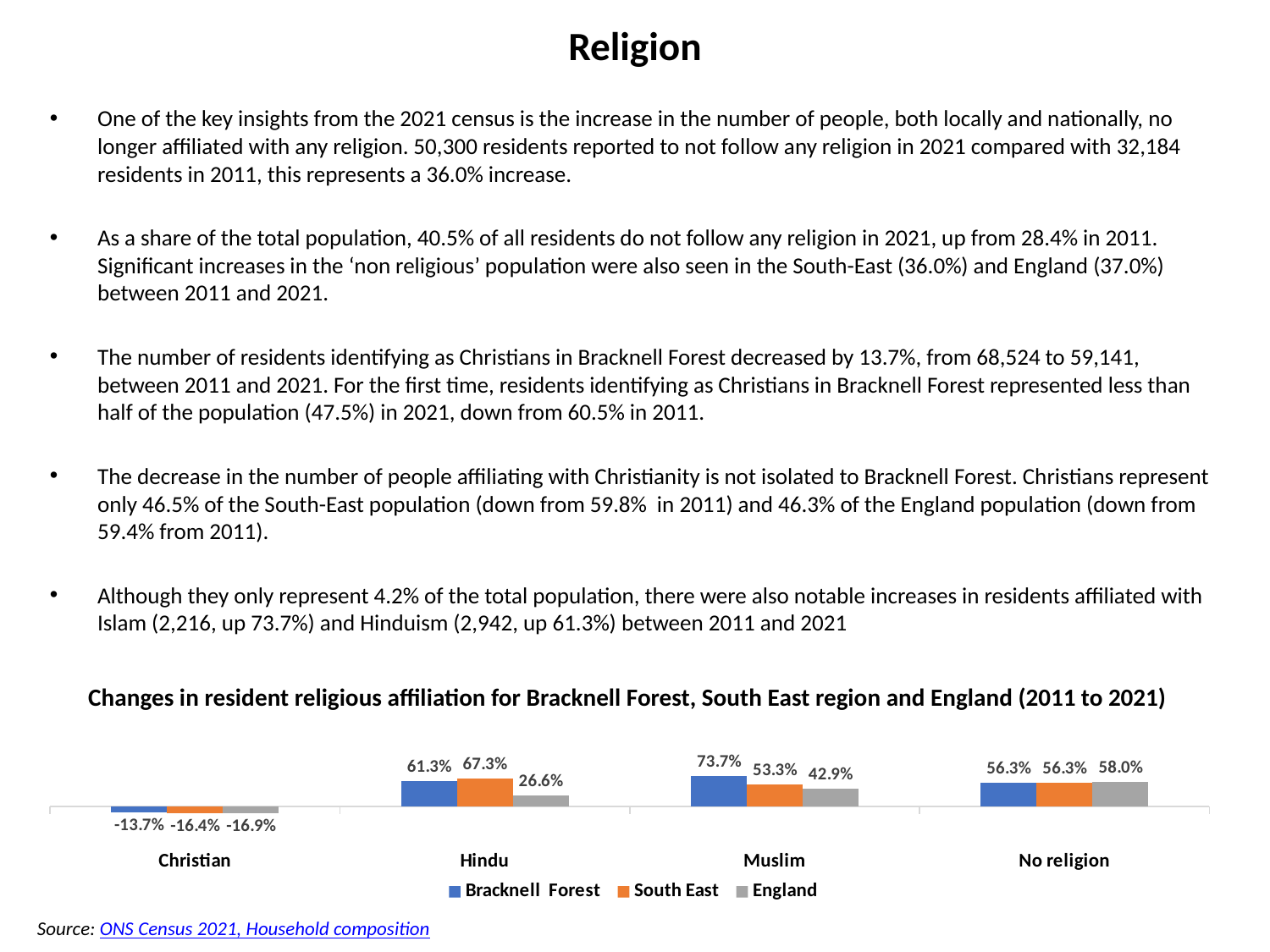
Which category has the highest value for Bracknell Forest? Muslim Which is larger in the Muslim category: the Bracknell Forest value or the South East value? Bracknell Forest Which series is shown in orange in the legend? South East What is the difference between the Bracknell Forest and England values in the Hindu category? 34.7% What kind of chart is shown on the slide? Bar chart What is the value for South East in the Hindu category? 67.3% How many series does the legend list? 3 What is the value for Bracknell Forest in the Christian category? -13.7% How many categories are shown on the x axis? 4 What is the value for England in the No religion category? 58.0% What is the value for England in the Muslim category? 42.9% Which category has the lowest value for England? Christian